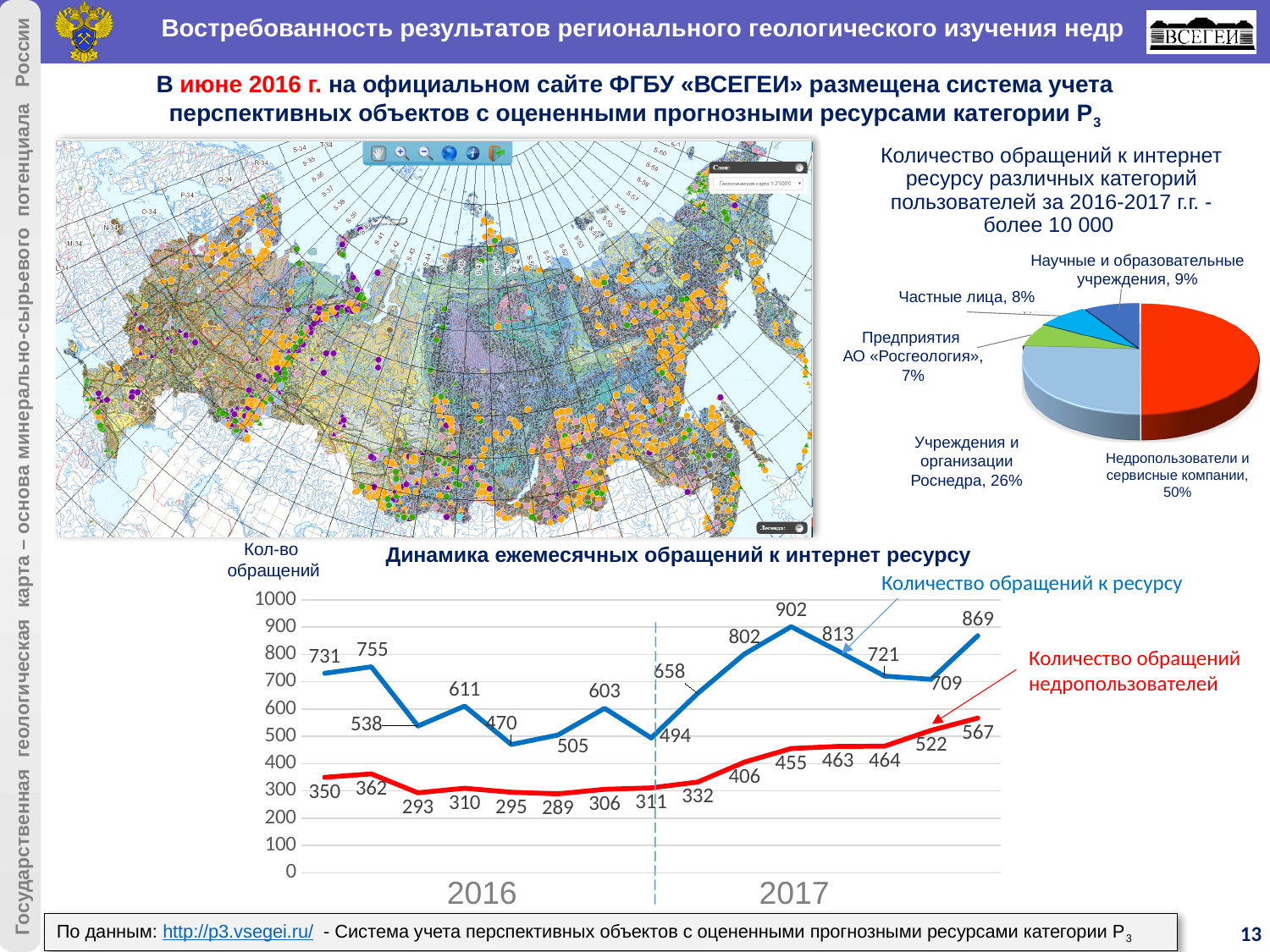
In the pie chart, which user category has the largest share? Недропользователи и сервисные компании What kind of chart is the chart titled 'Динамика ежемесячных обращений к интернет ресурсу'? line chart In the chart 'Динамика ежемесячных обращений к интернет ресурсу', what is the difference between the first value of 'Количество обращений к ресурсу' (731) and the first value of 'Количество обращений недропользователей' (350)? 381 In the pie chart, what share of requests comes from 'Недропользователи и сервисные компании'? 50% In the pie chart, what is the difference between the share of 'Учреждения и организации Роснедра' and 'Частные лица'? 18% In the pie chart, how many user categories are shown? 5 In the chart 'Динамика ежемесячных обращений к интернет ресурсу', what is the lowest value of the series 'Количество обращений недропользователей'? 289 In the pie chart, which user category has the smallest share? Предприятия АО «Росгеология» In the chart 'Динамика ежемесячных обращений к интернет ресурсу', how many series are plotted? 2 In the chart 'Динамика ежемесячных обращений к интернет ресурсу', what is the highest value of the series 'Количество обращений к ресурсу'? 902 In the chart 'Динамика ежемесячных обращений к интернет ресурсу', how many data points does each series have? 15 In the chart 'Динамика ежемесячных обращений к интернет ресурсу', which series has the larger final value: 'Количество обращений к ресурсу' or 'Количество обращений недропользователей'? Количество обращений к ресурсу